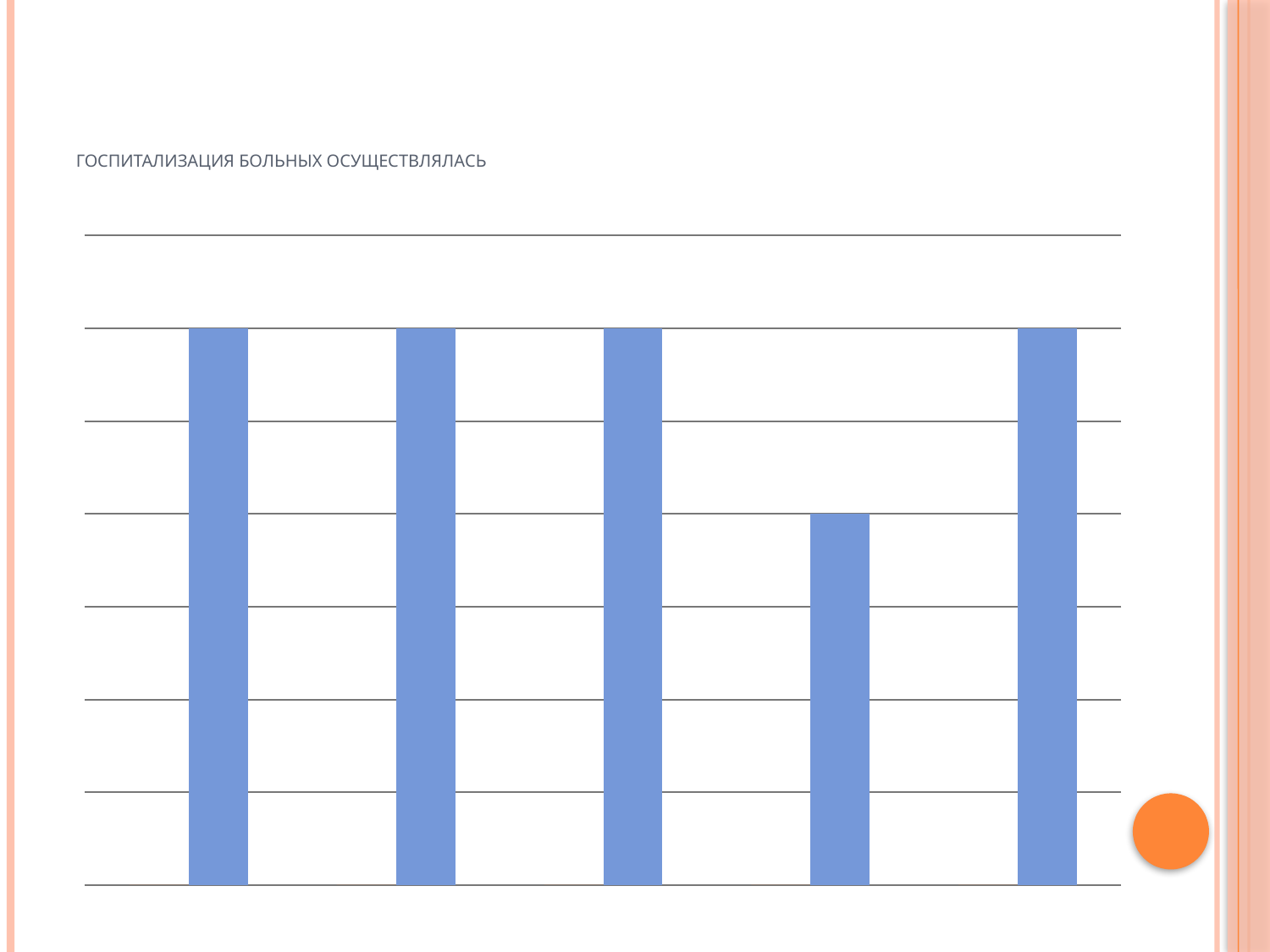
What is the title of the chart on the slide? ГОСПИТАЛИЗАЦИЯ БОЛЬНЫХ ОСУЩЕСТВЛЯЛАСЬ Which is larger, the fourth bar from the left or the fifth bar from the left? the fifth bar Which bar is the lowest in the chart? the fourth bar from the left How many bars in the chart are taller than the fourth bar from the left? 4 What kind of chart is shown on the slide? bar chart Which is larger, the first bar from the left or the fourth bar from the left? the first bar How many bars does the chart contain? 5 What colour are the bars in the chart? blue